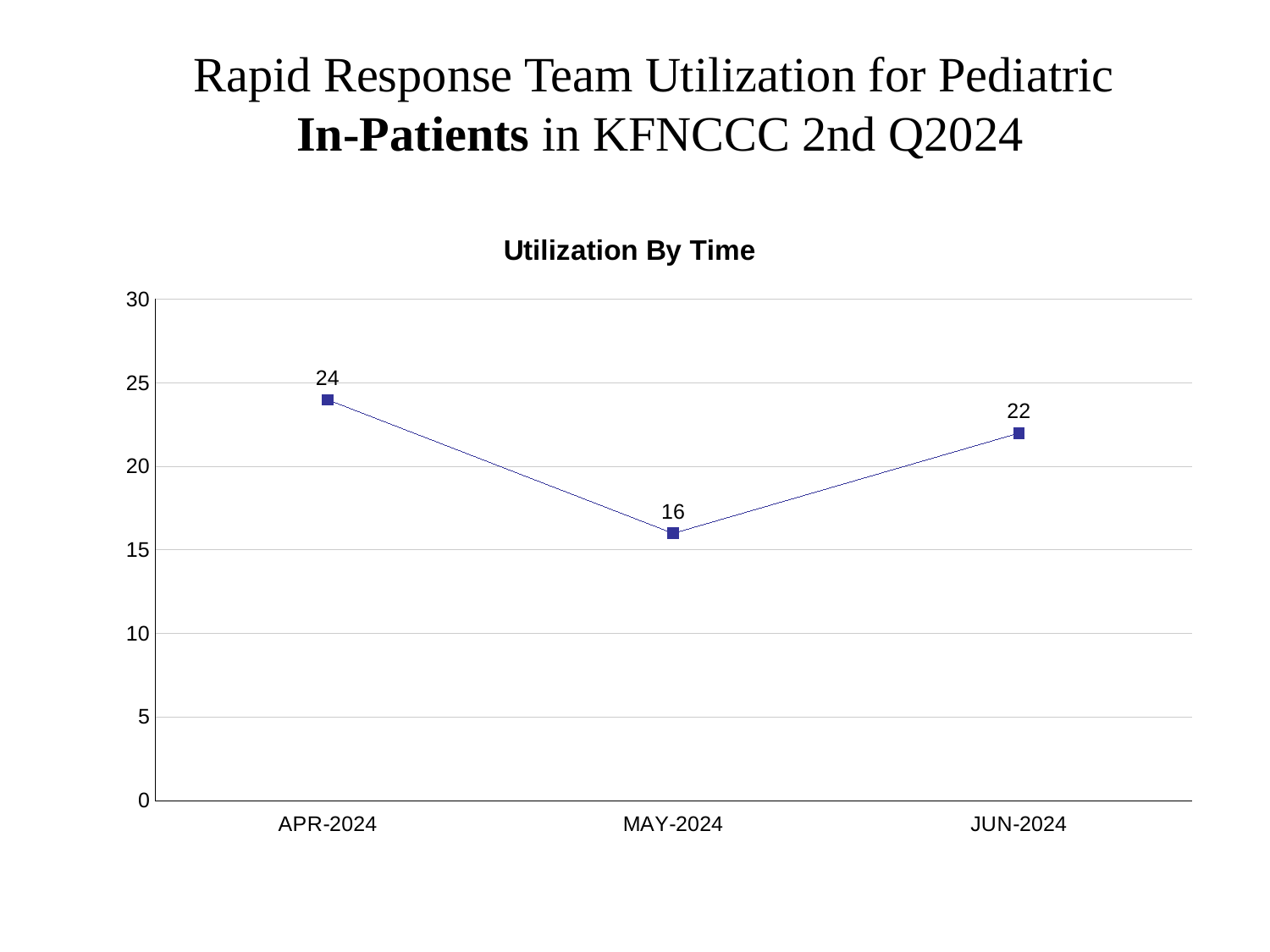
Which month has the lowest value? MAY-2024 What kind of chart is shown on the slide? line chart What is the title of the chart? Utilization By Time Is the value for MAY-2024 greater or less than 20? less What is the value for JUN-2024? 22 Which is larger, the value for APR-2024 or the value for JUN-2024? APR-2024 Which month has the highest value? APR-2024 What is the value for MAY-2024? 16 How many months are plotted on the chart? 3 What is the difference between the values for JUN-2024 and MAY-2024? 6 What is the difference between the values for APR-2024 and MAY-2024? 8 What is the value for APR-2024? 24